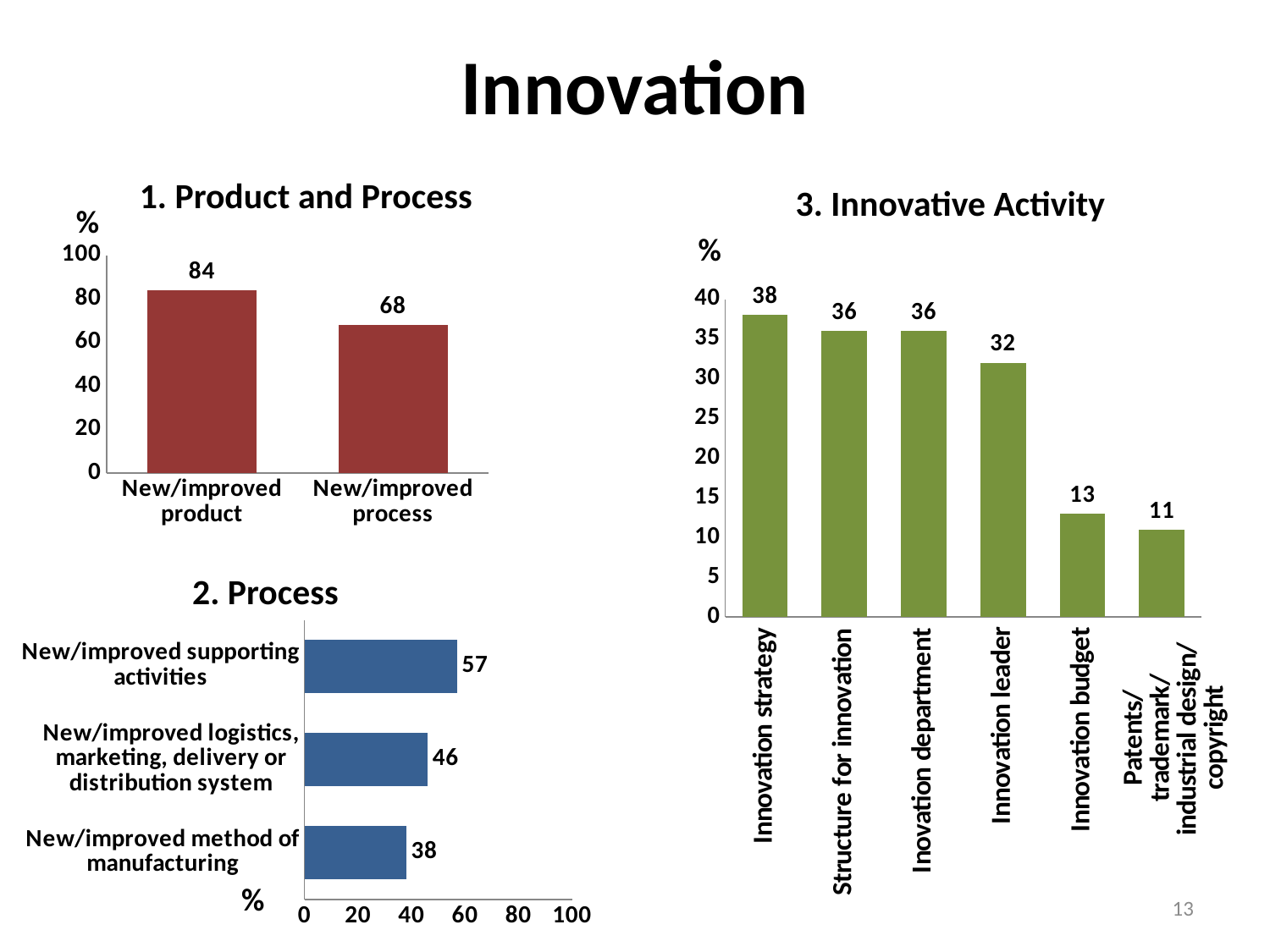
In the '3. Innovative Activity' chart, how many categories are shown? 6 In the '3. Innovative Activity' chart, which category has the highest value? Innovation strategy In the '2. Process' chart, how many categories are shown? 3 In the '2. Process' chart, which category has the lowest value? New/improved method of manufacturing In the '2. Process' chart, what is the value for New/improved logistics, marketing, delivery or distribution system? 46 In the '3. Innovative Activity' chart, which category has the lowest value? Patents/trademark/industrial design/copyright In the '1. Product and Process' chart, what is the value for New/improved product? 84 In the '3. Innovative Activity' chart, which is larger: Innovation budget or Innovation leader? Innovation leader In the '2. Process' chart, what kind of chart is it? Bar chart In the '3. Innovative Activity' chart, what is the value for Innovation leader? 32 In the '3. Innovative Activity' chart, do the values rise or fall from left to right? Fall In the '1. Product and Process' chart, what is the difference between New/improved product and New/improved process? 16